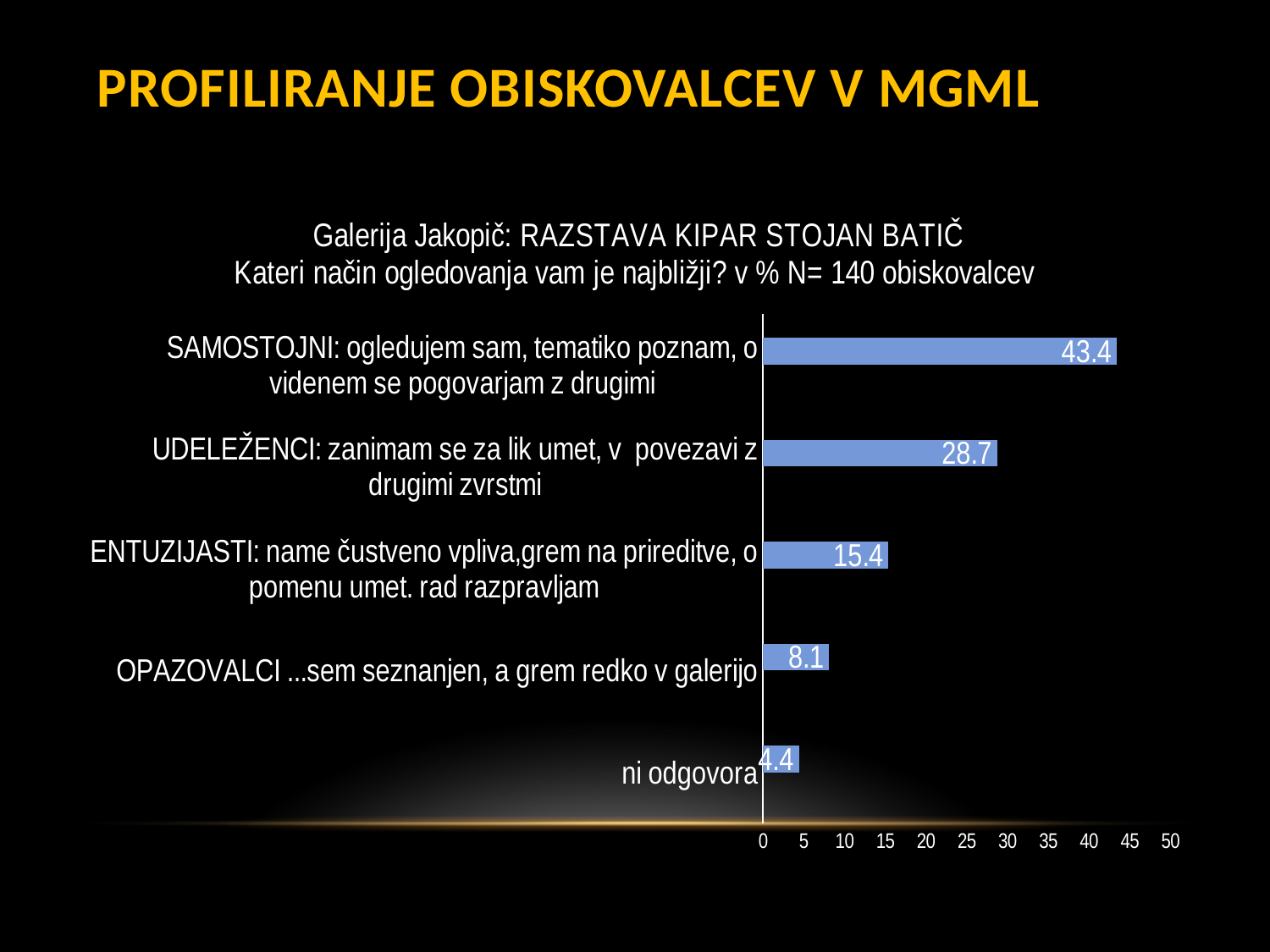
What is the value for the ENTUZIJASTI category? 15.4 What kind of chart is shown on the slide? Bar chart According to the chart title, how many visitors (N) were surveyed? 140 How many categories are shown in the chart? 5 What is the difference between the SAMOSTOJNI and UDELEŽENCI values? 14.7 What is the value for 'ni odgovora'? 4.4 What is the value for the OPAZOVALCI category? 8.1 Which category has the lowest value? ni odgovora Which category has the highest value? SAMOSTOJNI What is the value for the UDELEŽENCI category? 28.7 Which is larger, the value for ENTUZIJASTI or the value for OPAZOVALCI? ENTUZIJASTI What is the value for the SAMOSTOJNI category? 43.4